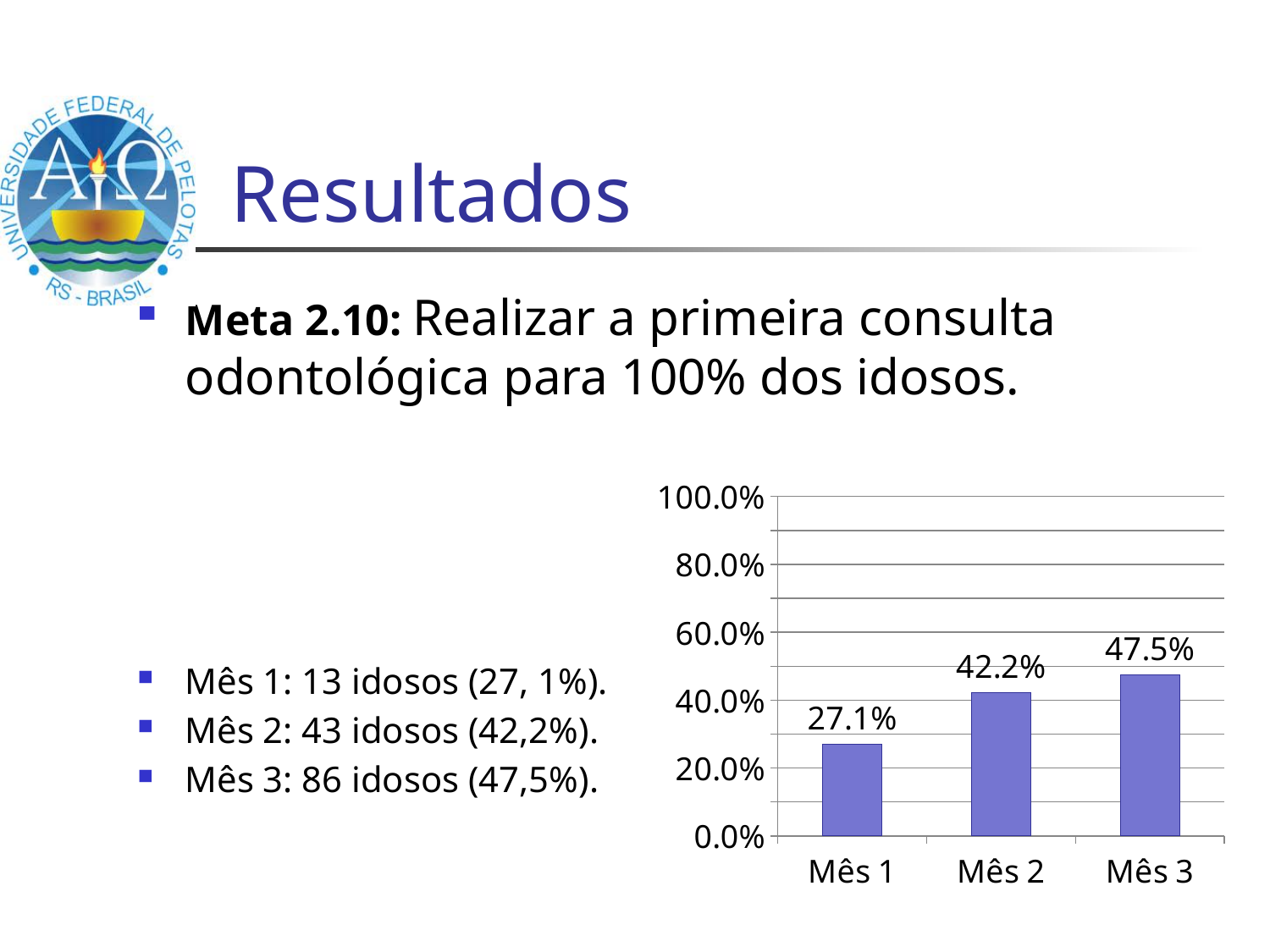
What kind of chart is shown on the slide? bar chart Which month has the highest value? Mês 3 How many categories are shown on the x axis? 3 Is the value for Mês 3 greater or less than 60.0%? less What is the difference between the values for Mês 3 and Mês 1? 20.4% What is the difference between the values for Mês 2 and Mês 1? 15.1% What is the value for Mês 1? 27.1% Which month has the lowest value? Mês 1 Do the values rise or fall from Mês 1 to Mês 3? rise What is the value for Mês 2? 42.2% Which is larger, the value for Mês 2 or Mês 3? Mês 3 What is the value for Mês 3? 47.5%